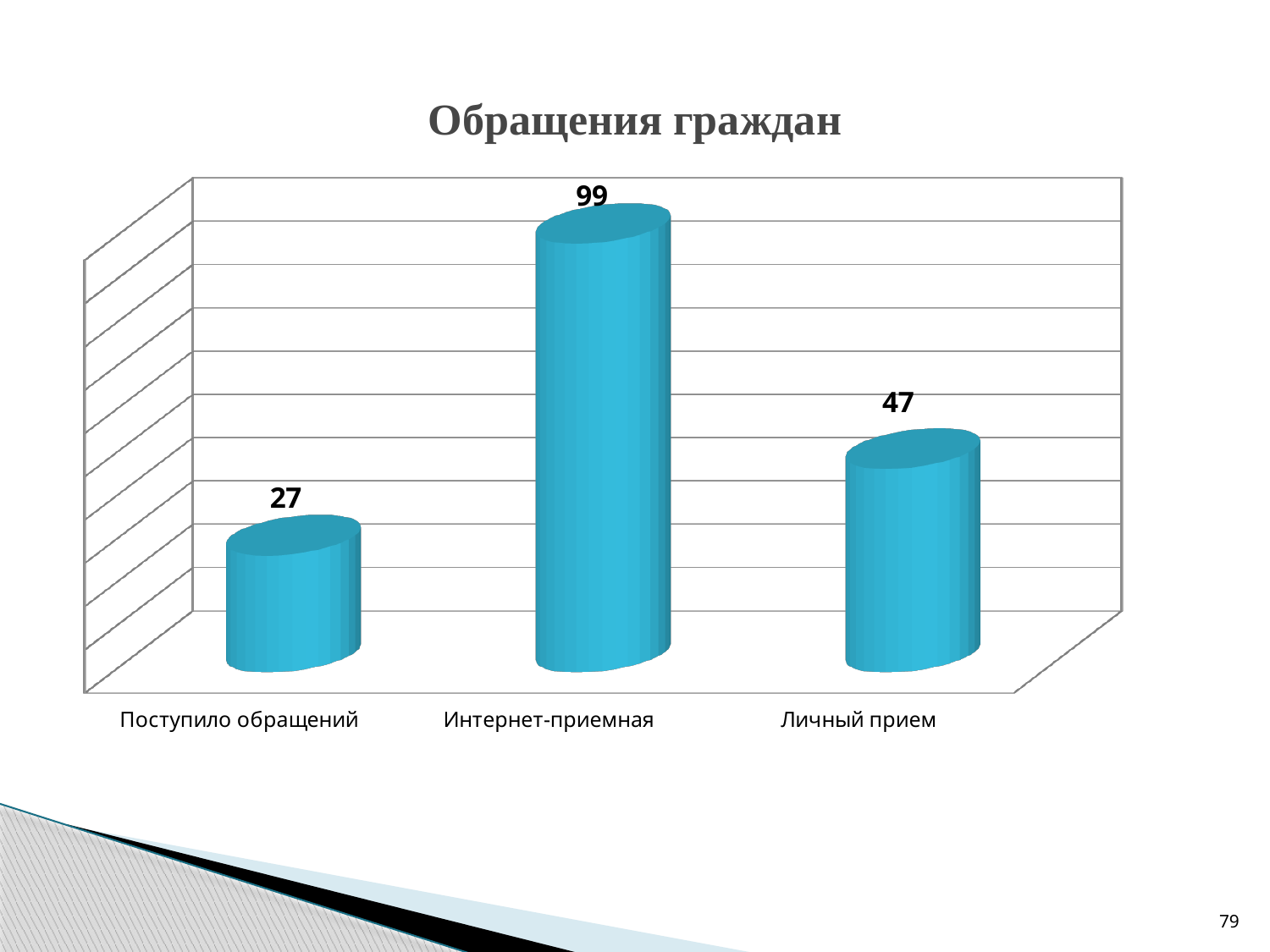
What is the title of the chart? Обращения граждан Which is larger, the value for Личный прием or the value for Поступило обращений? Личный прием What is the difference between the values for Интернет-приемная and Личный прием? 52 What is the value for Поступило обращений? 27 How many categories are shown on the chart? 3 What is the value for Личный прием? 47 Which category has the highest value? Интернет-приемная Which category has the lowest value? Поступило обращений What is the difference between the values for Личный прием and Поступило обращений? 20 What kind of chart is shown on the slide? bar chart What is the value for Интернет-приемная? 99 What colour are the bars in the chart? blue